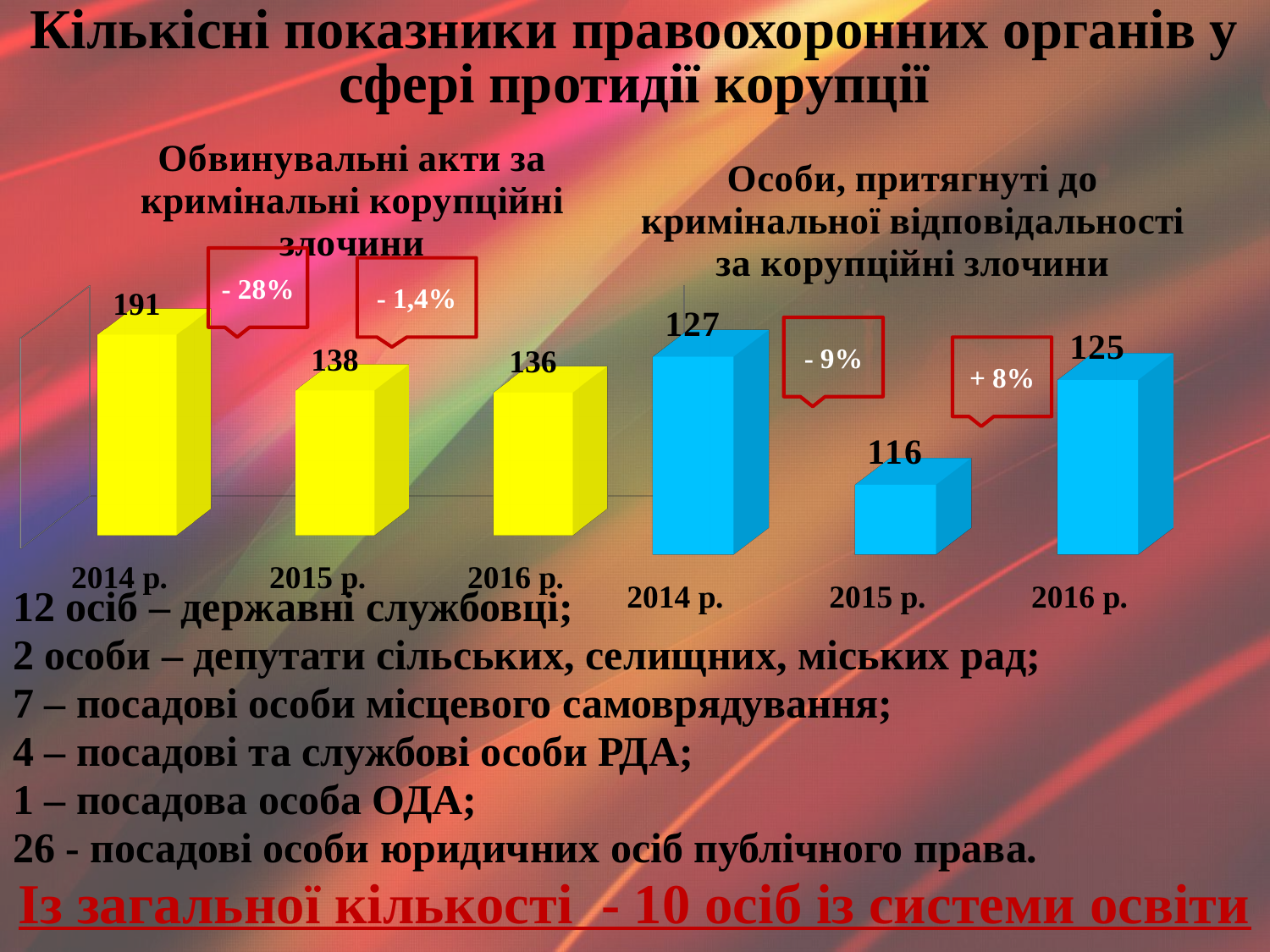
In the right chart, which year has the lowest value? 2015 р. How many years (categories) are shown in the left chart? 3 In the left chart, which year has the highest value? 2014 р. In the right chart (Особи, притягнуті до кримінальної відповідальності за корупційні злочини), what is the value for 2016 р.? 125 In the left chart, what is the difference between the values for 2014 р. and 2015 р.? 53 In the right chart, what is the difference between the values for 2014 р. and 2015 р.? 11 In the left chart, do the values rise or fall from 2014 р. to 2016 р.? Fall In the right chart, which is larger: the value for 2014 р. or the value for 2015 р.? 2014 р. In the left chart (Обвинувальні акти за кримінальні корупційні злочини), what is the value for 2016 р.? 136 In the right chart (Особи, притягнуті до кримінальної відповідальності за корупційні злочини), what is the value for 2015 р.? 116 In the left chart (Обвинувальні акти за кримінальні корупційні злочини), what is the value for 2014 р.? 191 What type of chart is the right chart (Особи, притягнуті до кримінальної відповідальності за корупційні злочини)? Bar chart